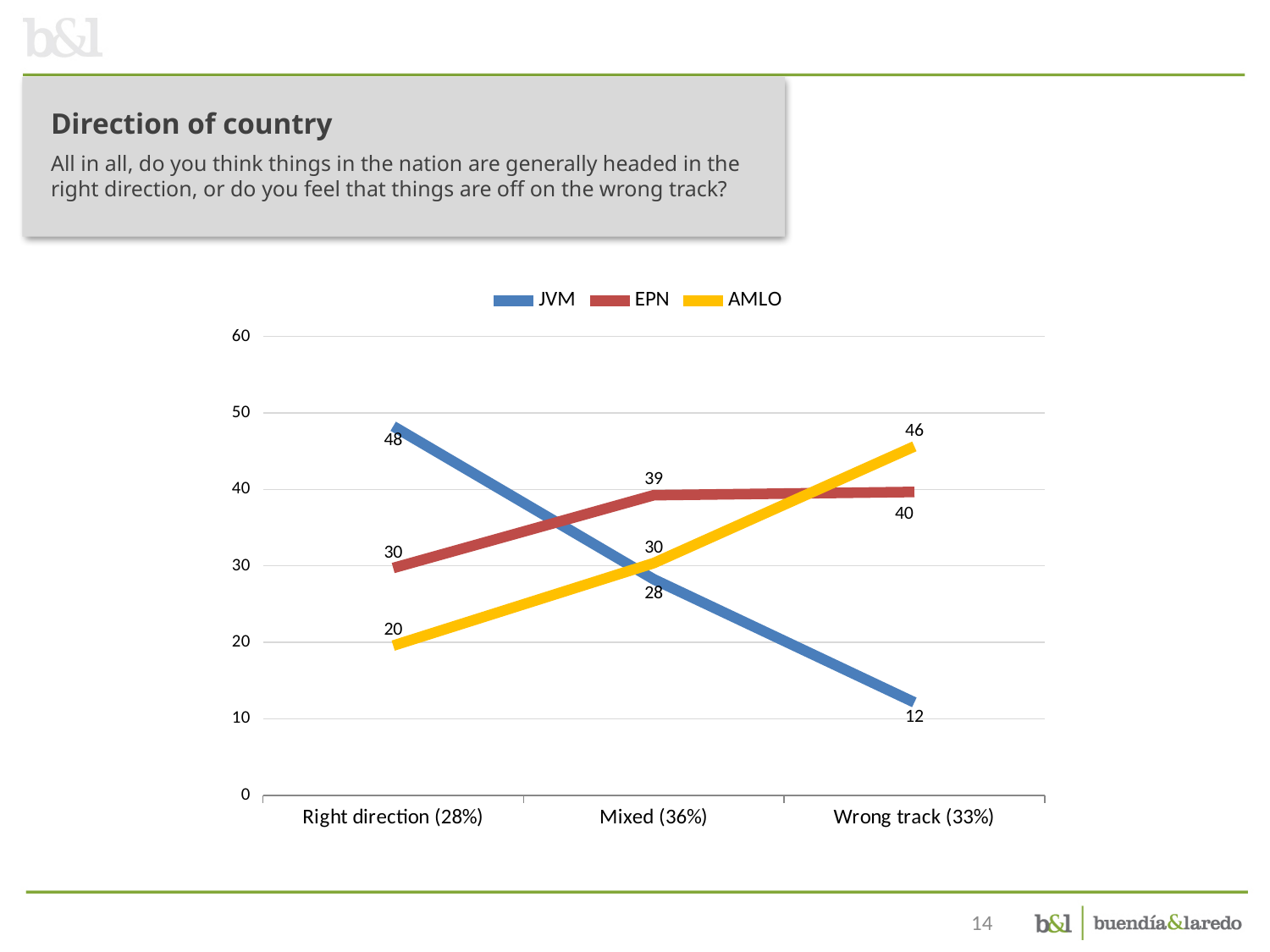
What is the difference between the JVM value at Right direction (28%) and at Wrong track (33%)? 36 Which category has the lowest value for JVM? Wrong track (33%) What is the value for EPN at Mixed (36%)? 39 What is the value for JVM at Right direction (28%)? 48 Does the JVM series rise or fall from Right direction (28%) to Wrong track (33%)? fall What kind of chart is shown on the slide? line chart How many series does the legend list? 3 What colour is the AMLO line? yellow At Wrong track (33%), which series has the larger value, EPN or AMLO? AMLO Which category has the highest value for AMLO? Wrong track (33%) What is the value for AMLO at Wrong track (33%)? 46 How many categories are shown on the x axis? 3